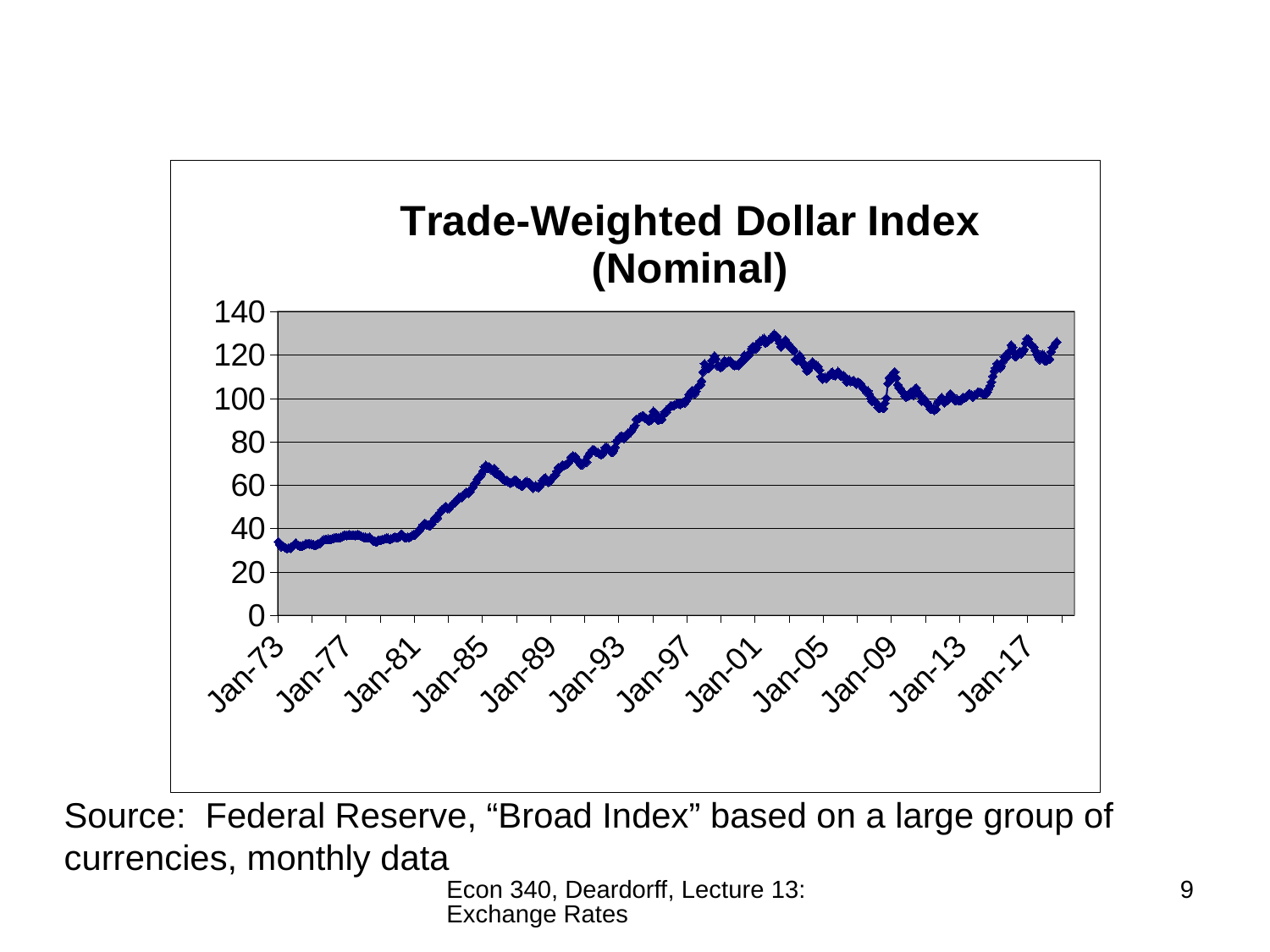
Is the value of the index at Jan-81 greater or less than 60? less What kind of chart is shown on the slide? line chart Is the value of the index at Jan-97 greater or less than 80? greater Overall, does the index rise or fall between Jan-73 and Jan-01? rise What is the highest value shown on the vertical axis of the chart? 140 Does the index rise or fall between Jan-01 and Jan-09? fall Is the value of the index at Jan-73 greater or less than 40? less Which is larger, the index value at Jan-73 or at Jan-01? Jan-01 How many year labels are shown along the x axis of the chart? 12 What is the title of the chart? Trade-Weighted Dollar Index (Nominal)